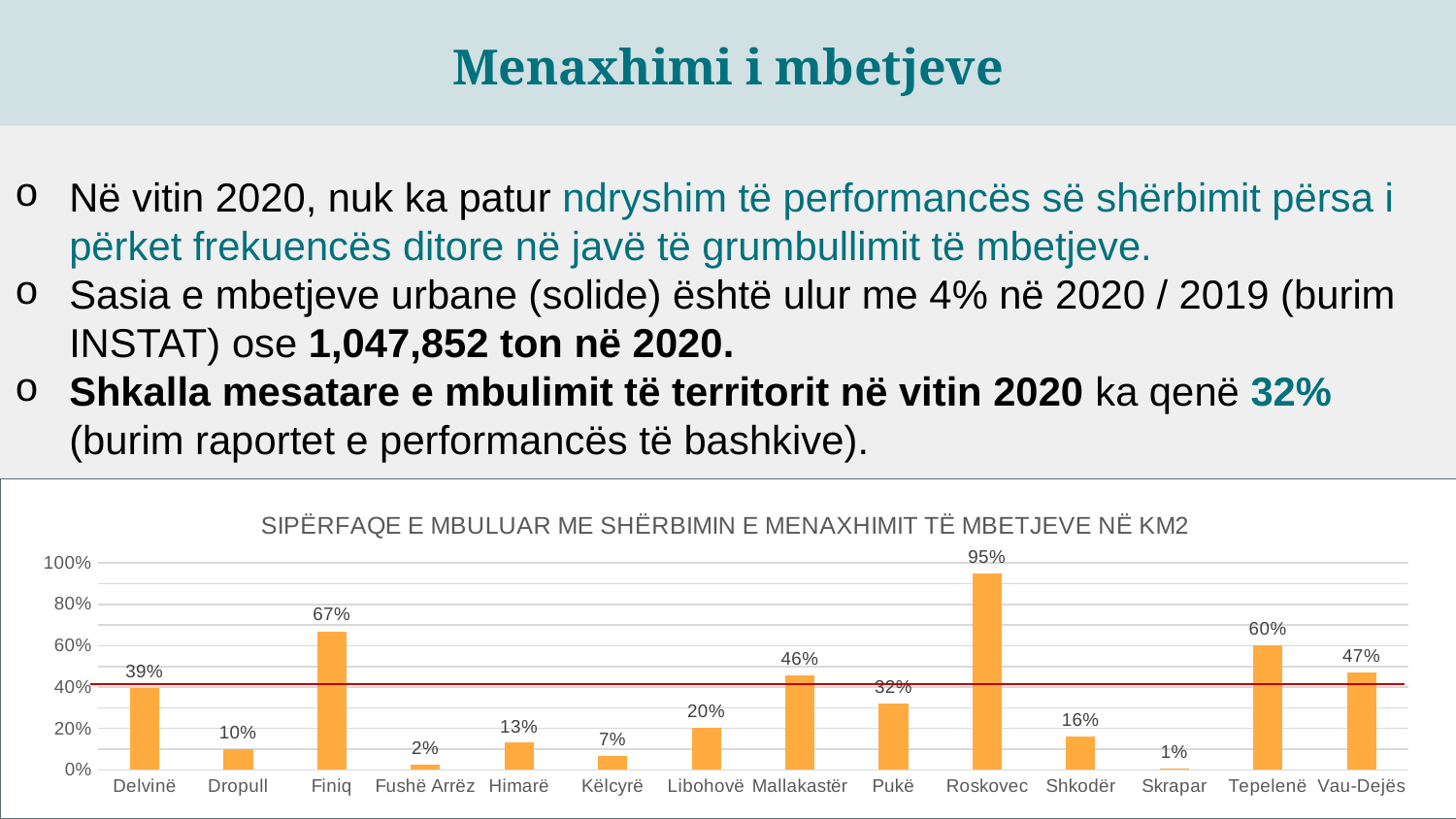
What is the value shown for Roskovec in the chart? 95% What is the value shown for Himarë in the chart? 13% Which municipality has the highest value in the chart? Roskovec What is the value shown for Finiq in the chart? 67% What is the difference between the values for Tepelenë and Pukë? 28% What type of chart is shown on the slide? Bar chart Which municipality has the lowest value in the chart? Skrapar How many municipalities are shown on the x axis of the chart? 14 What is the title of the chart? SIPËRFAQE E MBULUAR ME SHËRBIMIN E MENAXHIMIT TË MBETJEVE NË KM2 Which has a larger value, Mallakastër or Delvinë? Mallakastër What is the value shown for Vau-Dejës in the chart? 47% Is the value for Libohovë greater or less than 40%? less